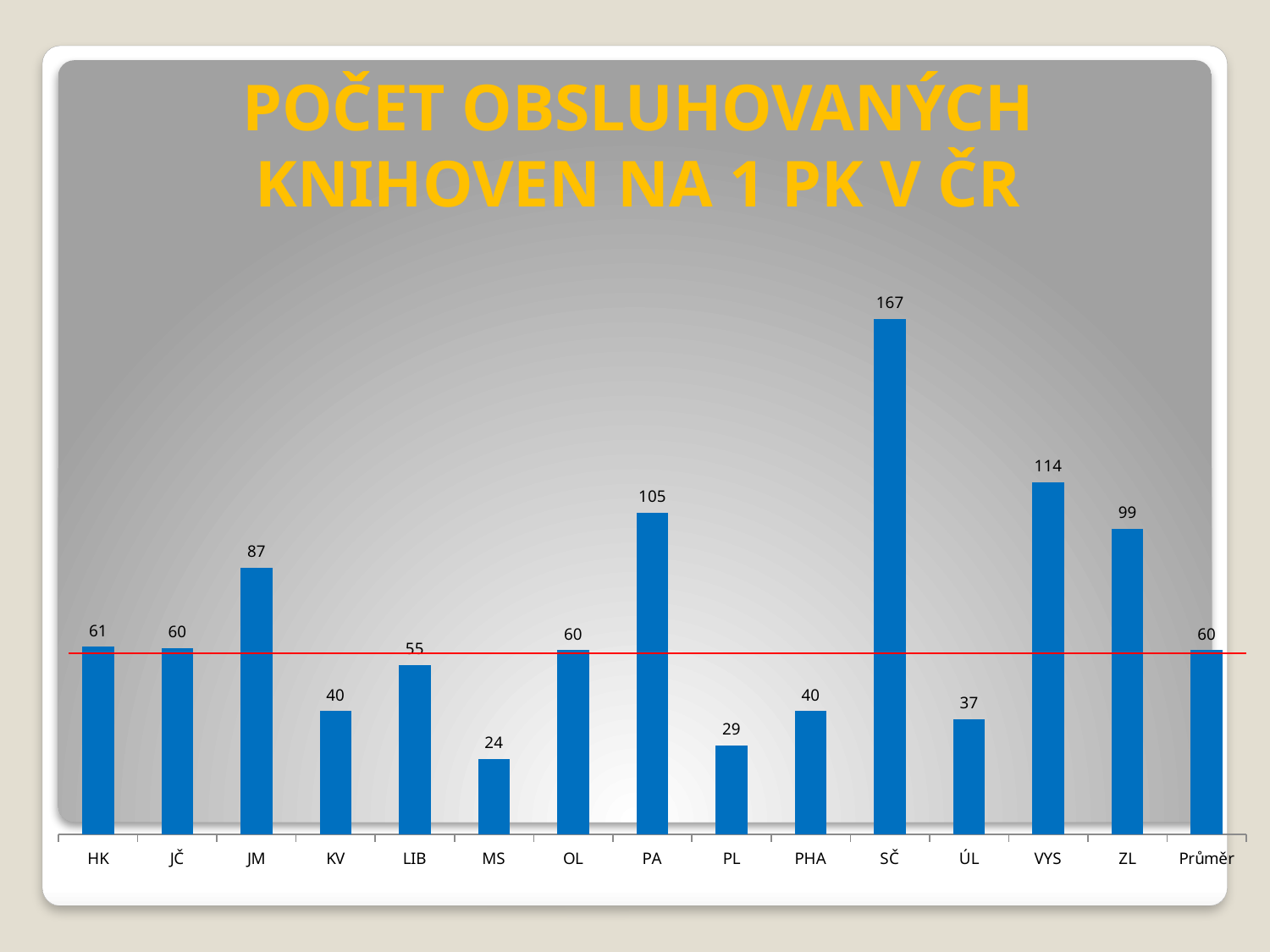
What is the title of the chart? POČET OBSLUHOVANÝCH KNIHOVEN NA 1 PK V ČR Which is larger, the value for JM or the value for ZL? ZL Which category has the lowest value? MS What is the value for SČ? 167 What is the value for VYS? 114 Which category has the highest value? SČ What is the difference between the values for PA and ZL? 6 What is the value for MS? 24 How many categories are shown on the x axis? 15 What is the value shown for Průměr? 60 What is the difference between the values for SČ and VYS? 53 What kind of chart is shown on the slide? bar chart